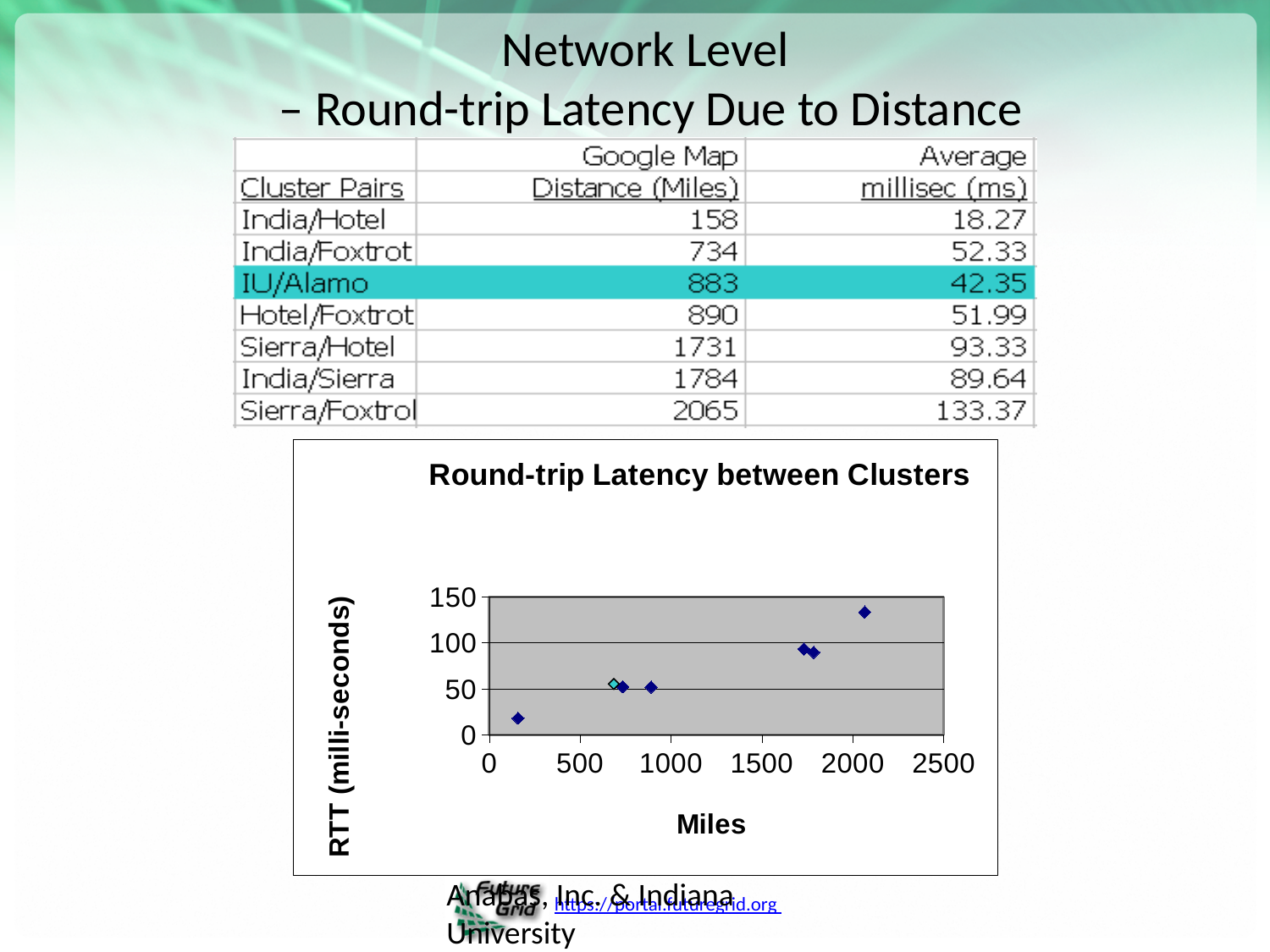
Which has the larger average latency, Sierra/Hotel or India/Sierra? Sierra/Hotel What is the title of the chart? Round-trip Latency between Clusters Do the RTT values generally rise or fall as Miles increases along the x axis? rise What is the average round-trip latency in milliseconds for the IU/Alamo cluster pair? 42.35 Is the RTT value for the point at about 2000 miles greater or less than 100? greater Which cluster pair has the lowest average round-trip latency? India/Hotel What kind of chart is shown on the slide? scatter chart Which cluster pair has the highest average round-trip latency? Sierra/Foxtrol Is the RTT value for the points near 1750 miles greater or less than 50? greater Is the RTT value for the point nearest 0 miles greater or less than 50? less What is the label of the y axis of the chart? RTT (milli-seconds)